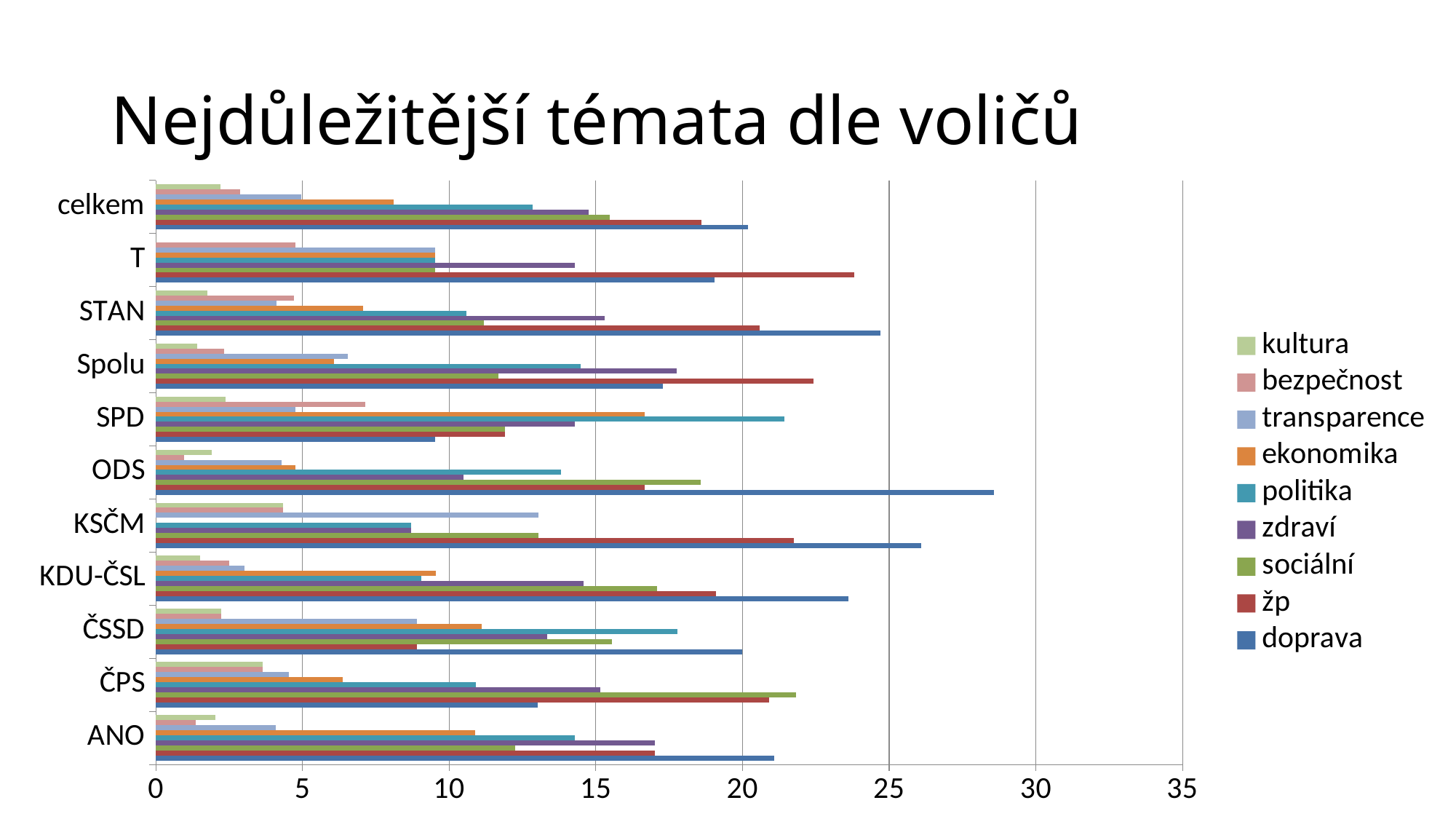
What kind of chart is shown on the slide? bar chart What is the title of the chart? Nejdůležitější témata dle voličů Is the value for žp for T greater or less than 20? greater How many categories are shown on the vertical axis? 11 How many series does the legend list? 9 Is the value for doprava for ODS greater or less than 25? greater Which is larger, the value for politika for SPD or the value for politika for ODS? SPD Which category has the highest value for doprava? ODS Which category has the lowest value for doprava? SPD Which is larger, the value for žp for Spolu or the value for žp for SPD? Spolu Which series has the highest value for T? žp Is the value for doprava for SPD greater or less than 10? less